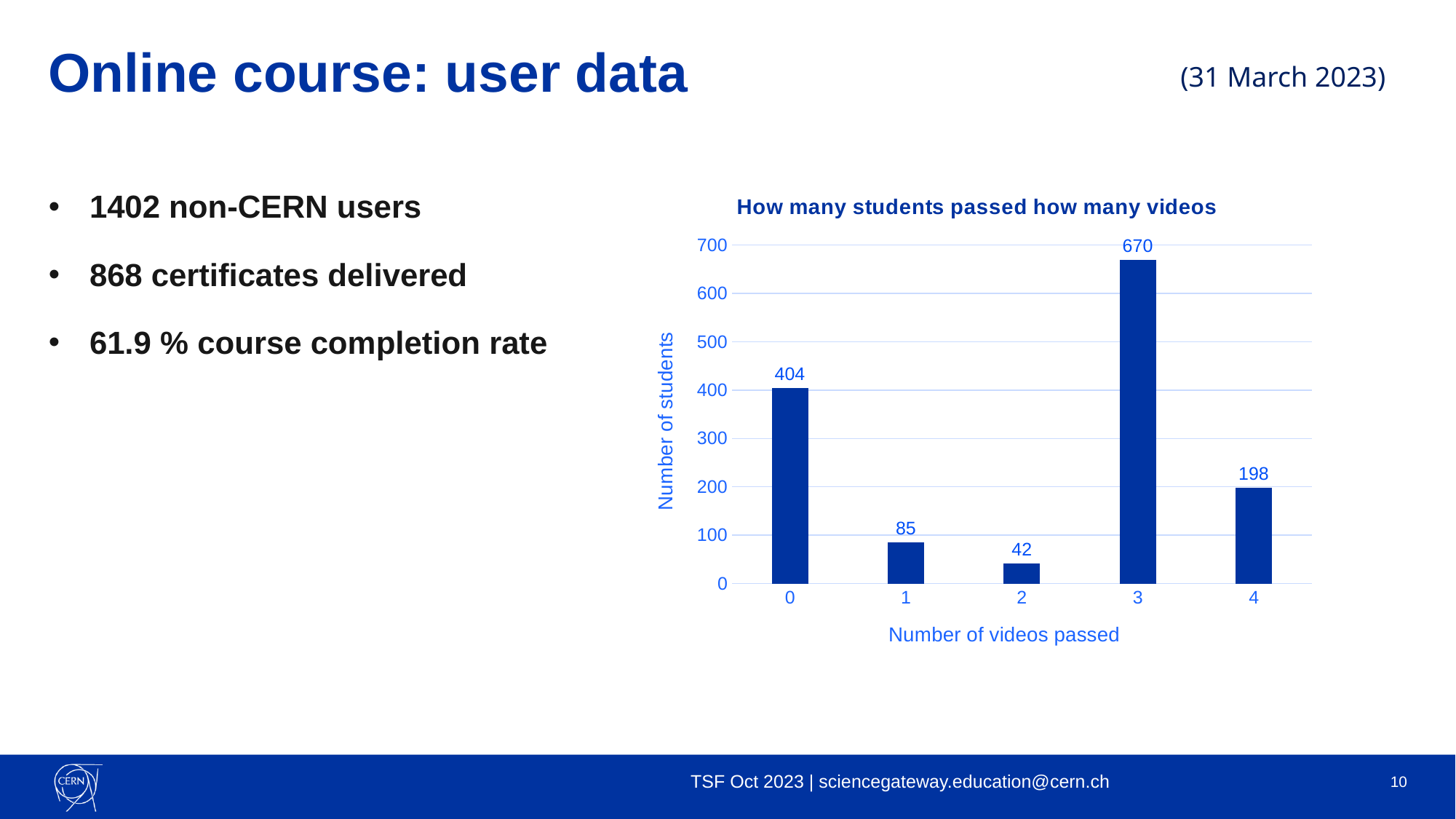
What is the difference between the number of students who passed 1 video and those who passed 2 videos? 43 How many students passed 3 videos? 670 How many students passed 0 videos? 404 Which number of videos passed has the highest number of students? 3 Is the number of students who passed 4 videos greater or less than 200? less What is the title of the chart? How many students passed how many videos Which number of videos passed has the lowest number of students? 2 How many students passed 4 videos? 198 What is the difference between the number of students who passed 3 videos and those who passed 0 videos? 266 What kind of chart is shown on the slide? bar chart How many categories are shown on the x axis of the chart? 5 Which has more students: 4 videos passed or 1 video passed? 4 videos passed